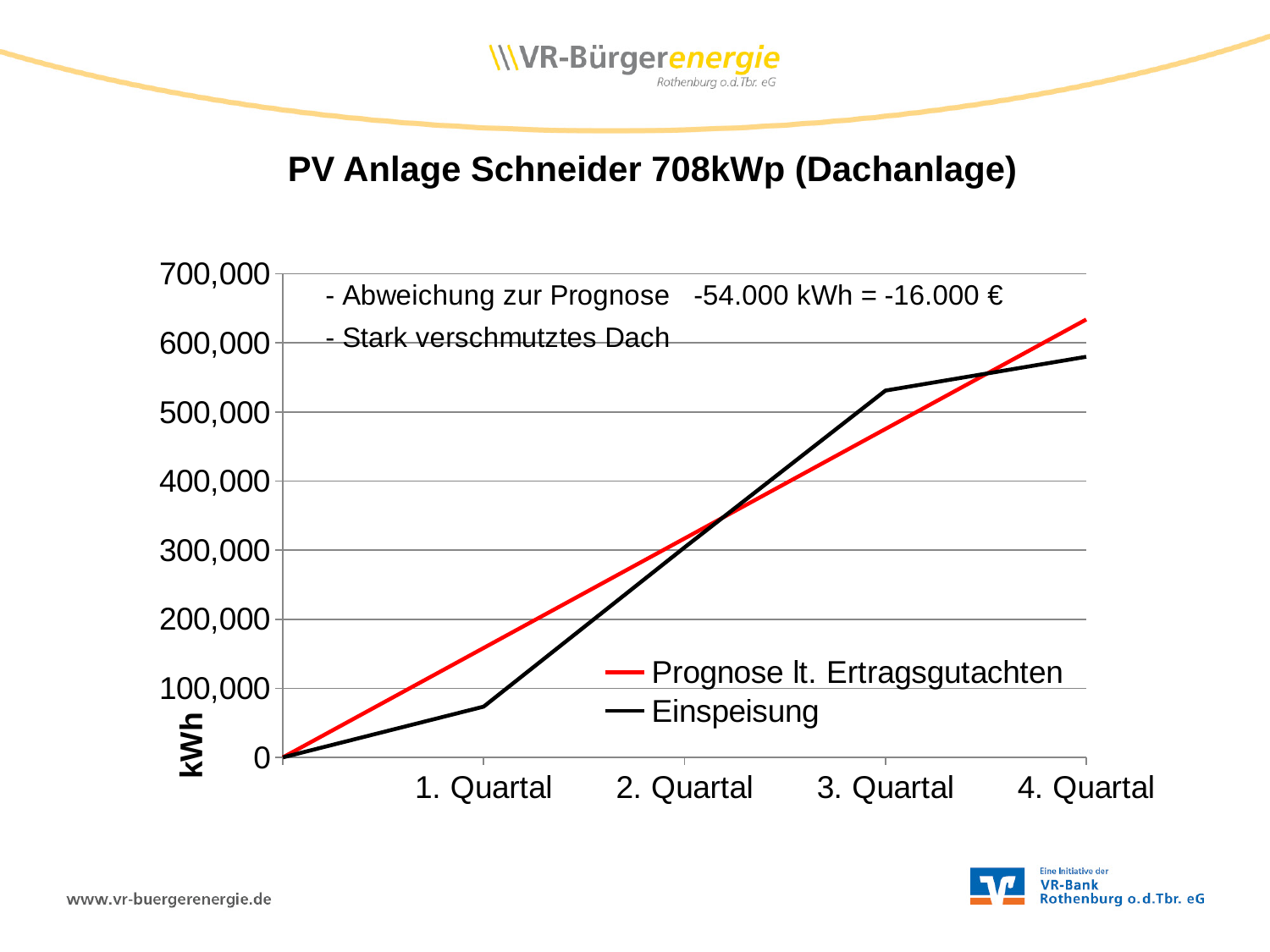
Is the Prognose lt. Ertragsgutachten value at 1. Quartal greater or less than 100,000? greater Is the Einspeisung value at 3. Quartal greater or less than 500,000? greater How many quarters are labelled on the x axis? 4 What colour is the Prognose lt. Ertragsgutachten line? red Does the Einspeisung line rise or fall from 1. Quartal to 4. Quartal? rise At 4. Quartal, which series has the higher value, Prognose lt. Ertragsgutachten or Einspeisung? Prognose lt. Ertragsgutachten What kind of chart is shown on the slide? line chart At 3. Quartal, which series has the higher value, Prognose lt. Ertragsgutachten or Einspeisung? Einspeisung Is the Einspeisung value at 1. Quartal greater or less than 100,000? less How many series does the legend list? 2 What unit is shown on the y axis label? kWh